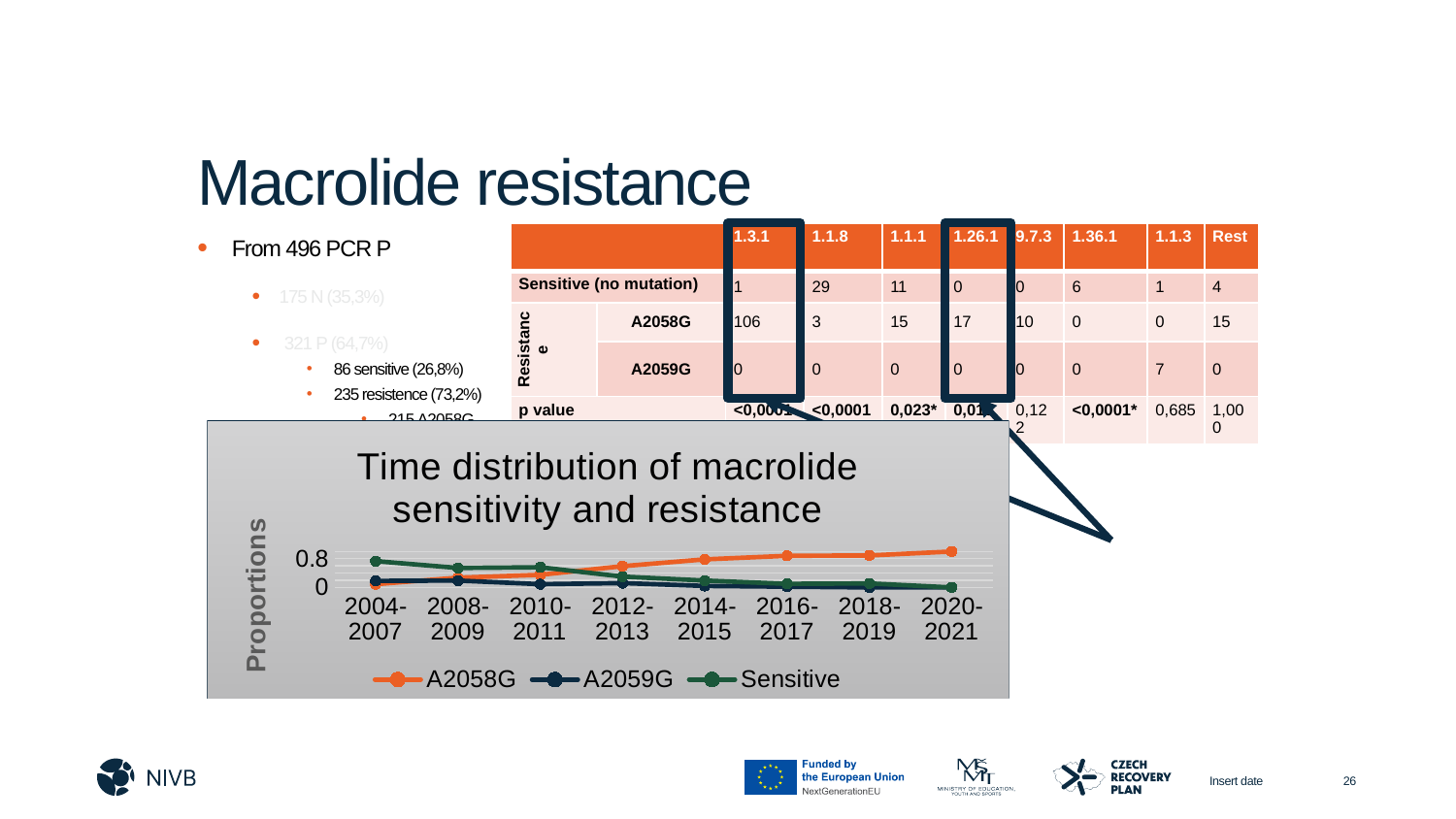
Does the Sensitive series rise or fall from 2004-2007 to 2020-2021? fall In 2004-2007, which series has the highest proportion? Sensitive Does the A2058G series rise or fall from 2004-2007 to 2020-2021? rise In 2020-2021, which series has the highest proportion? A2058G Which series are listed in the chart's legend? A2058G, A2059G, Sensitive What is the title of the chart? Time distribution of macrolide sensitivity and resistance How many time periods are shown along the x axis of the chart? 8 What kind of chart is shown on the slide? line chart How many series does the chart's legend list? 3 In which period is the A2058G proportion highest? 2020-2021 In 2004-2007, which is larger: the Sensitive proportion or the A2058G proportion? Sensitive Is the A2059G proportion in 2020-2021 greater or less than 0.8? less